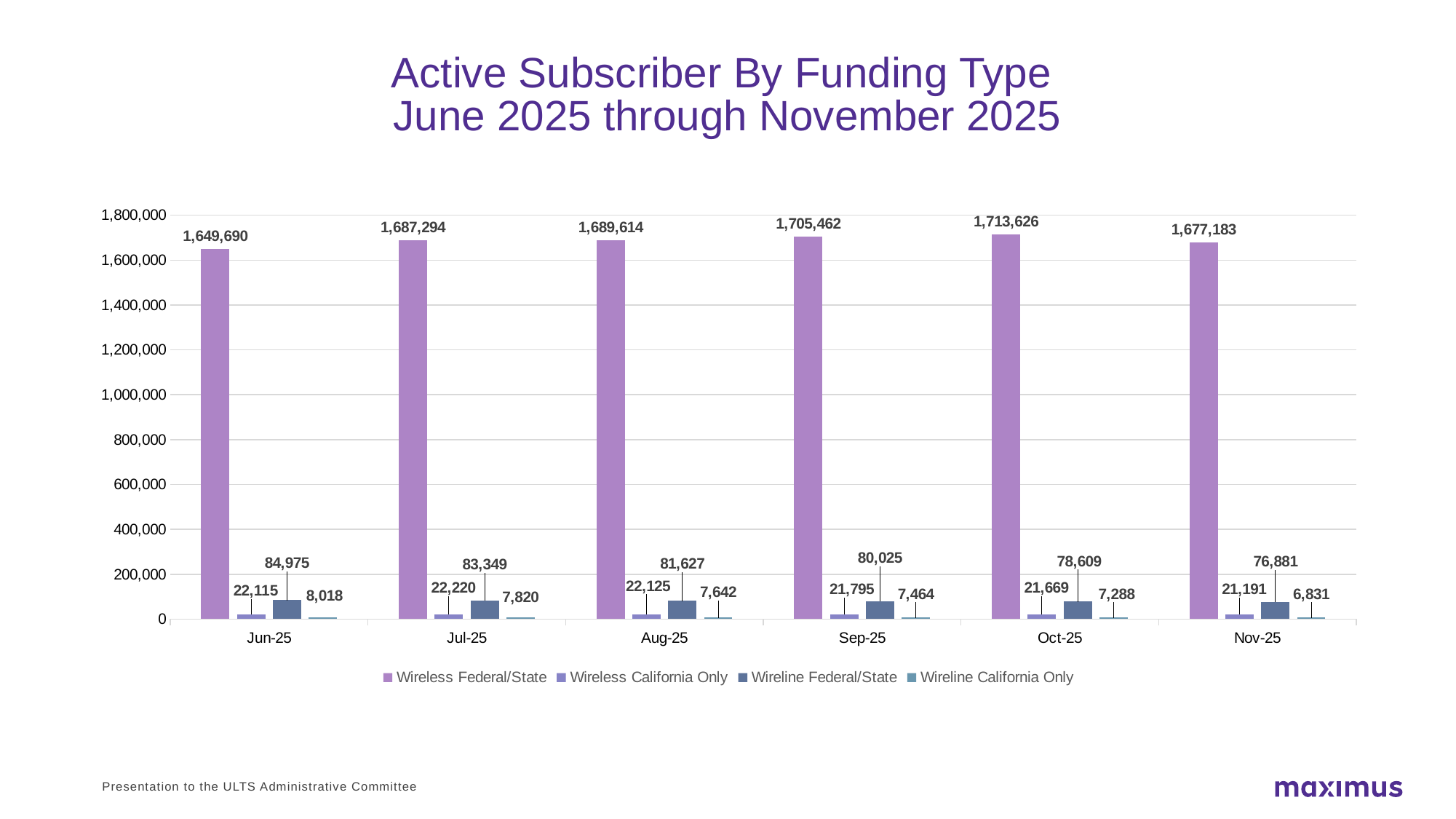
Which is larger, the Wireless California Only value for Jul-25 or for Aug-25? Jul-25 Does the Wireline Federal/State value rise or fall from Jun-25 to Nov-25? fall How many series does the legend list? 4 Is the value for Wireless Federal/State in Jun-25 greater or less than 1,600,000? greater What is the value for Wireless California Only in Oct-25? 21,669 In which month is the Wireless Federal/State value highest? Oct-25 What is the difference between the Wireless Federal/State values for Oct-25 and Nov-25? 36,443 In which month is the Wireline Federal/State value lowest? Nov-25 How many months are shown on the x axis? 6 What is the value for Wireline California Only in Nov-25? 6,831 What is the value for Wireline Federal/State in Jun-25? 84,975 What is the value for Wireless Federal/State in Sep-25? 1,705,462